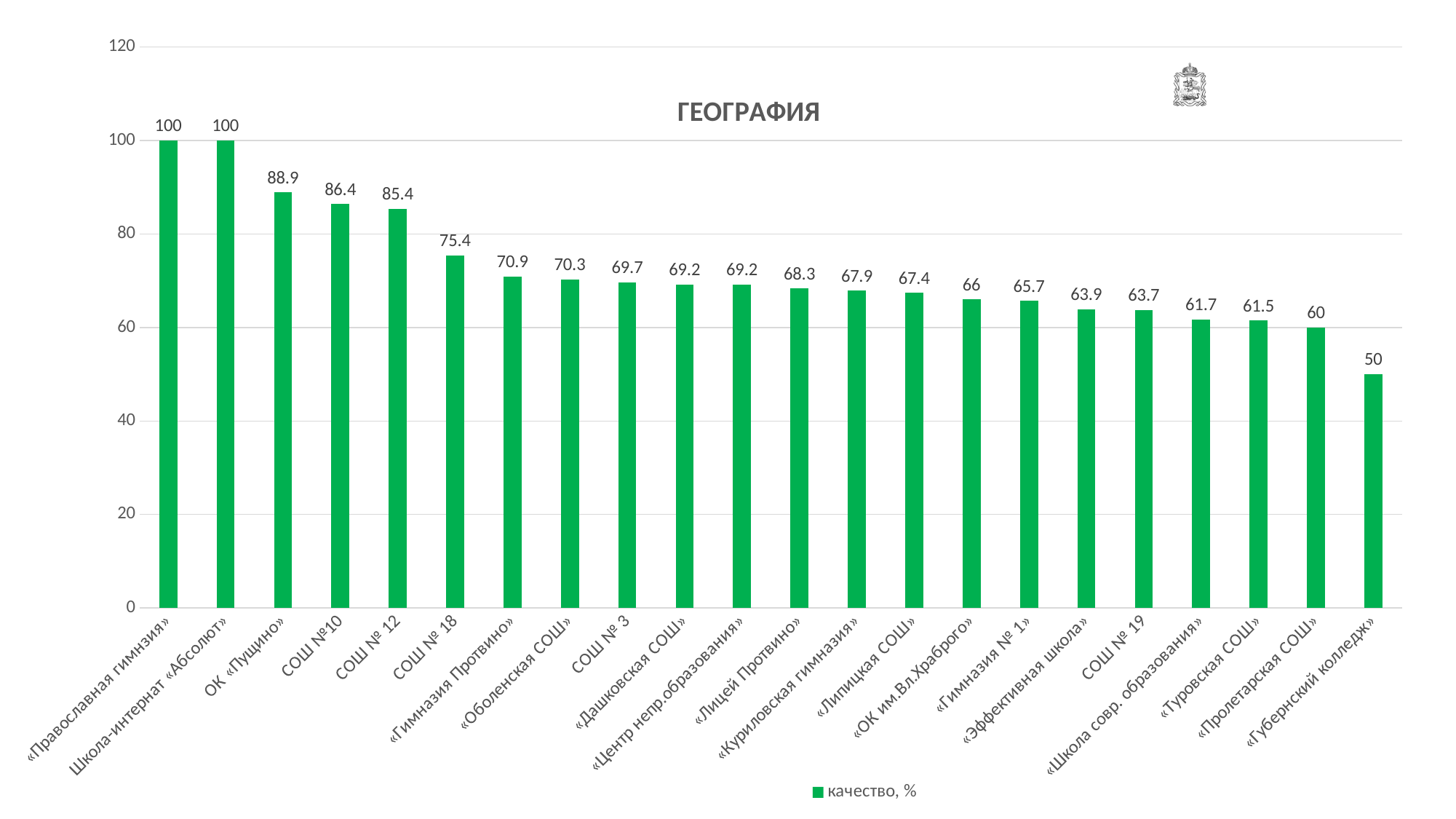
Which is larger, the value for «Лицей Протвино» or the value for «Липицкая СОШ»? «Лицей Протвино» What is the value for СОШ № 18? 75.4 Is the value for «Пролетарская СОШ» greater or less than 80? less What is the title of the chart? ГЕОГРАФИЯ What is the value for «Туровская СОШ»? 61.5 What is the highest value shown on the chart? 100 How many categories are shown on the chart? 22 How many series does the legend list? 1 Which category has the lowest value? «Губернский колледж» What kind of chart is this? bar chart What is the difference between the values for ОК «Пущино» and СОШ №10? 2.5 What is the value for «Гимназия Протвино»? 70.9